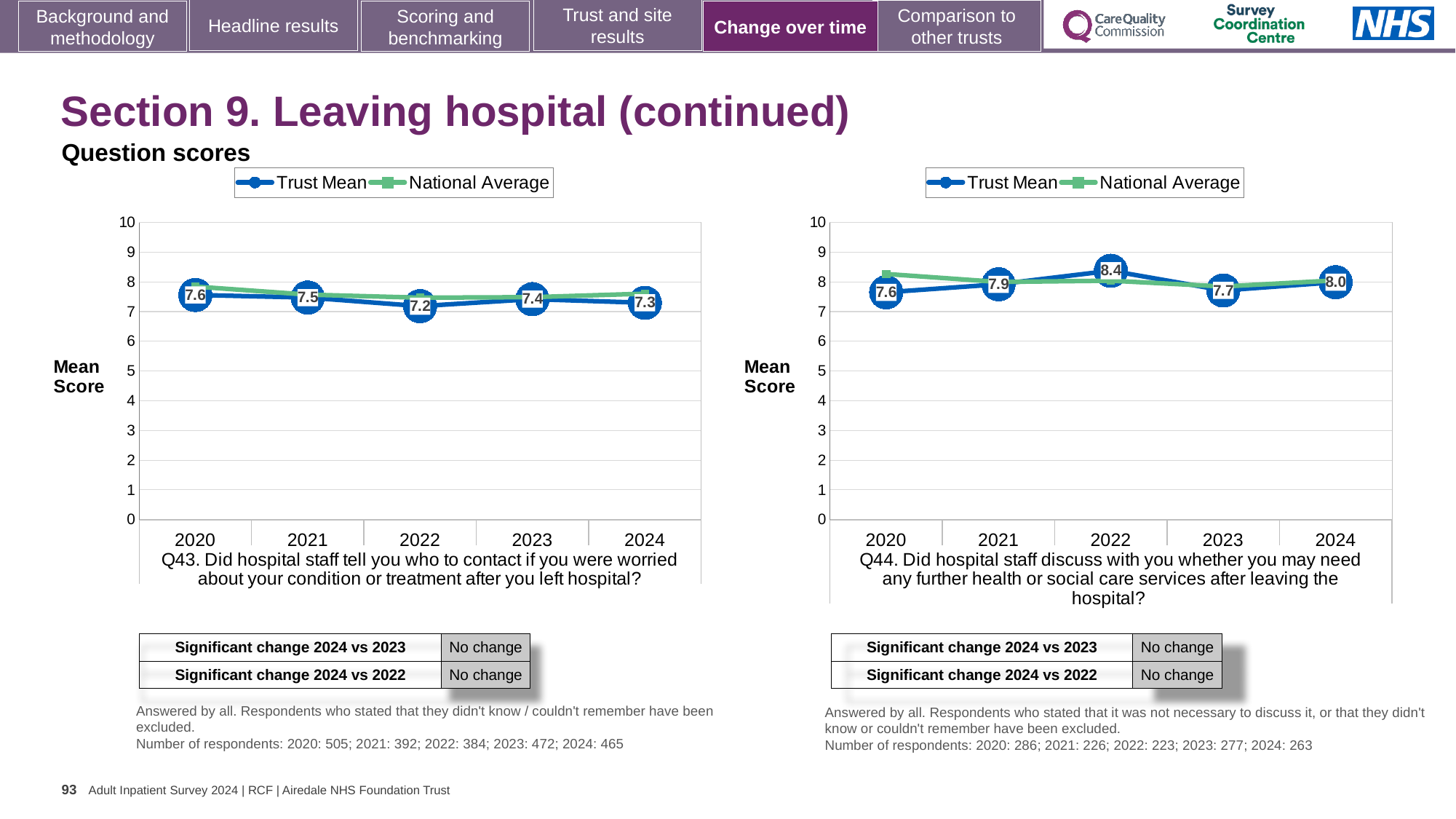
In the Q44 chart (right), what is the Trust Mean score for 2024? 8.0 In the Q44 chart (right), what is the difference between the Trust Mean scores for 2022 and 2020? 0.8 In the Q44 chart (right), what is the Trust Mean score for 2022? 8.4 In the Q43 chart (left), what is the Trust Mean score for 2020? 7.6 In the Q44 chart (right), is the National Average for 2020 greater or less than 8? greater How many years are plotted on the x axis of the Q43 chart (left)? 5 In the Q43 chart (left), is the Trust Mean score for 2021 or 2023 higher? 2021 What type of chart is used for Q43 (left)? Line chart In the Q44 chart (right), which year has the highest Trust Mean score? 2022 In the Q43 chart (left), which year has the lowest Trust Mean score? 2022 In the Q43 chart (left), what is the Trust Mean score for 2022? 7.2 How many series does the legend of the Q44 chart (right) list? 2